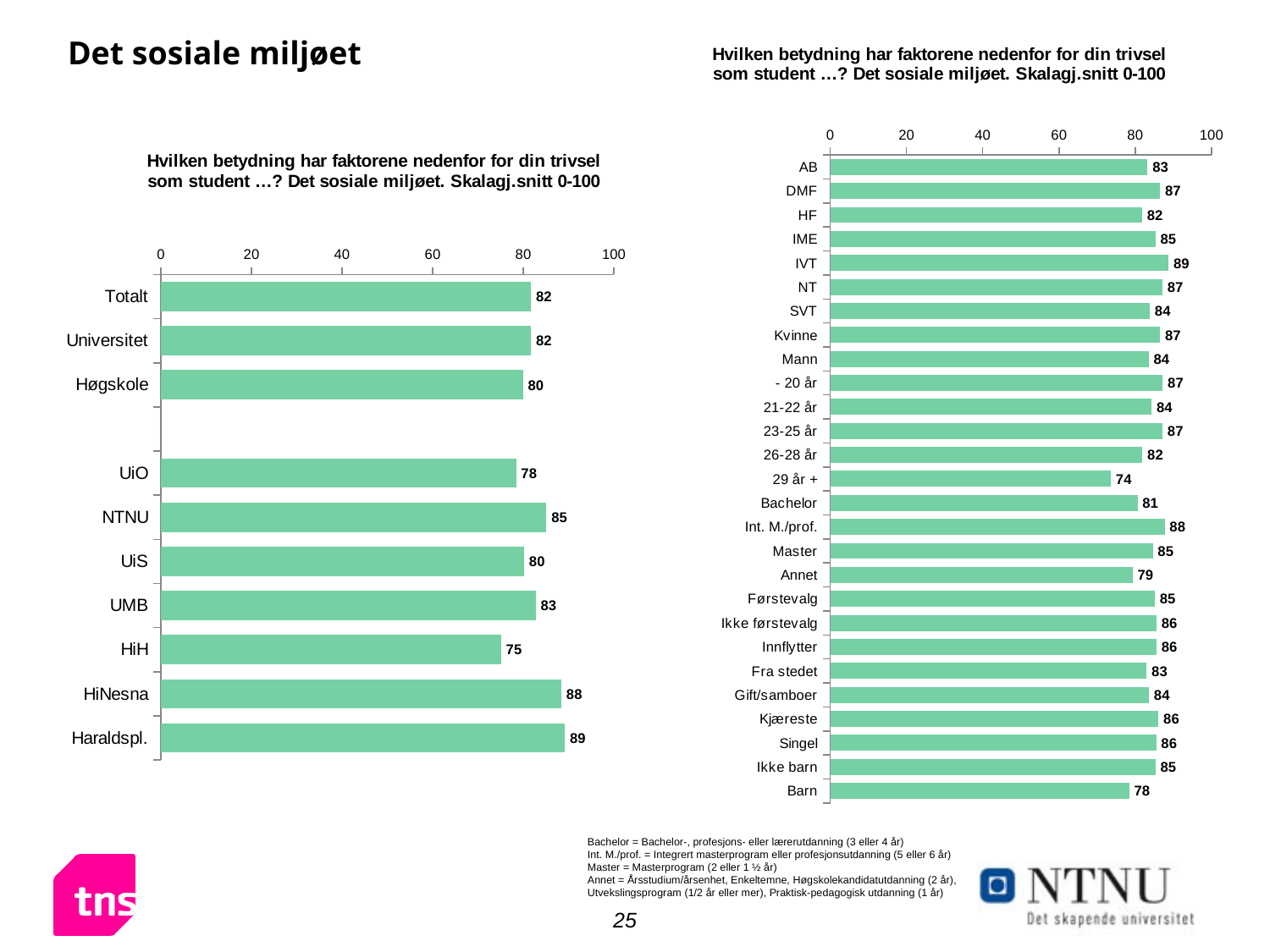
On the left chart, which category has the highest value? Haraldspl. On the right chart, which category has the lowest value? 29 år + On the right chart, which category has the highest value? IVT On the right chart, what is the value for Kvinne? 87 On the right chart, how many categories are plotted? 27 On the left chart, what is the difference between the values for HiNesna and UiO? 10 On the left chart, which category has the lowest value? HiH What kind of chart is the left chart? Bar chart On the left chart, what is the value for NTNU? 85 On the right chart, which is larger, the value for Bachelor or the value for Master? Master On the right chart, what is the difference between the values for Ikke barn and Barn? 7 On the left chart, how many categories are plotted? 10